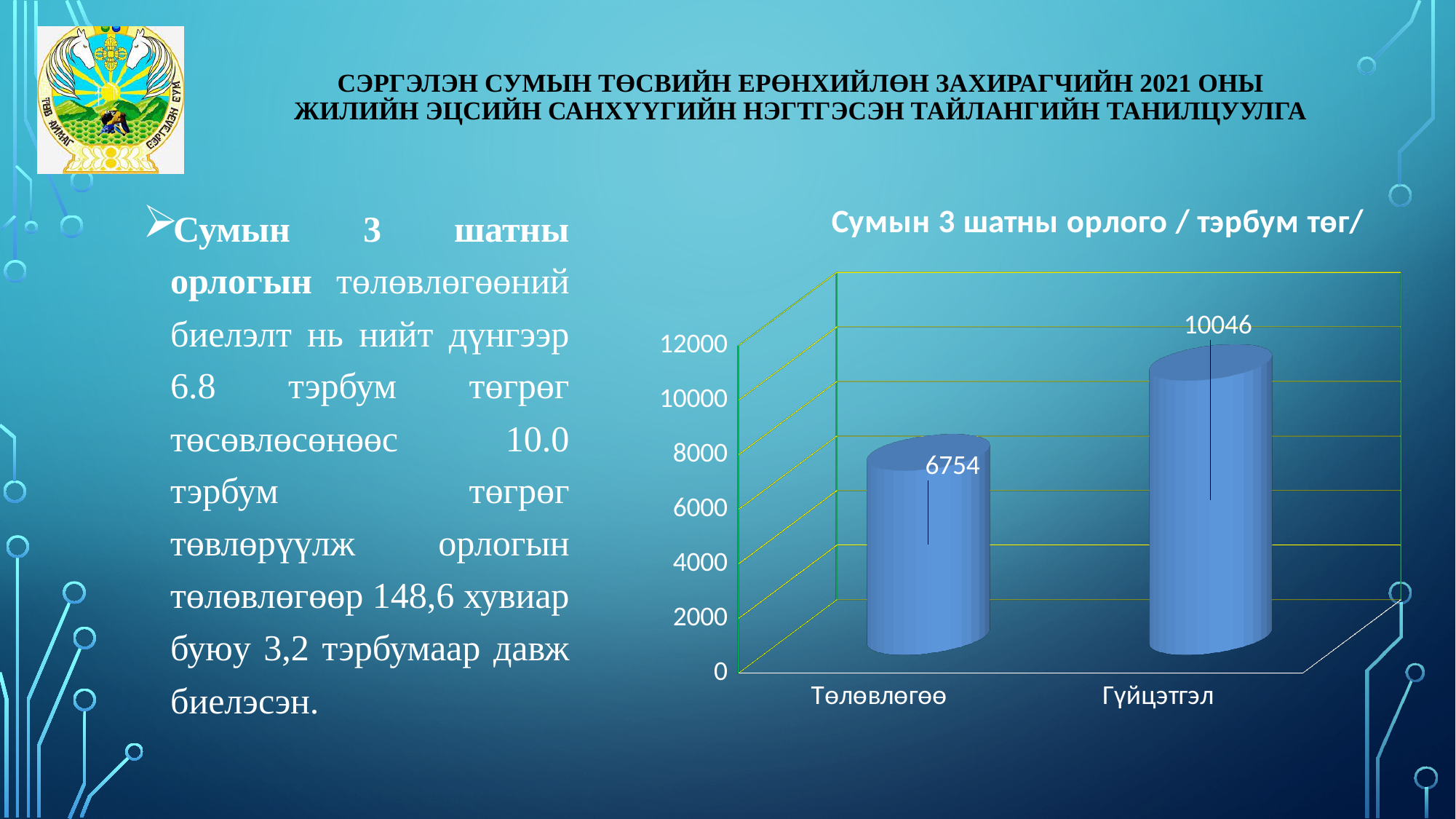
What is the title of the chart? Сумын 3 шатны орлого / тэрбум төг/ Which is larger, the value for Төлөвлөгөө or the value for Гүйцэтгэл? Гүйцэтгэл Which category has the highest value in the chart? Гүйцэтгэл What is the value for Гүйцэтгэл in the chart? 10046 Which category has the lowest value in the chart? Төлөвлөгөө What is the value for Төлөвлөгөө in the chart? 6754 What is the difference between the values for Гүйцэтгэл and Төлөвлөгөө? 3292 What kind of chart is shown on the slide? bar chart How many categories are shown in the chart? 2 Is the value for Гүйцэтгэл greater or less than 10000? greater Is the value for Төлөвлөгөө greater or less than 8000? less What is the highest value shown on the vertical axis of the chart? 12000